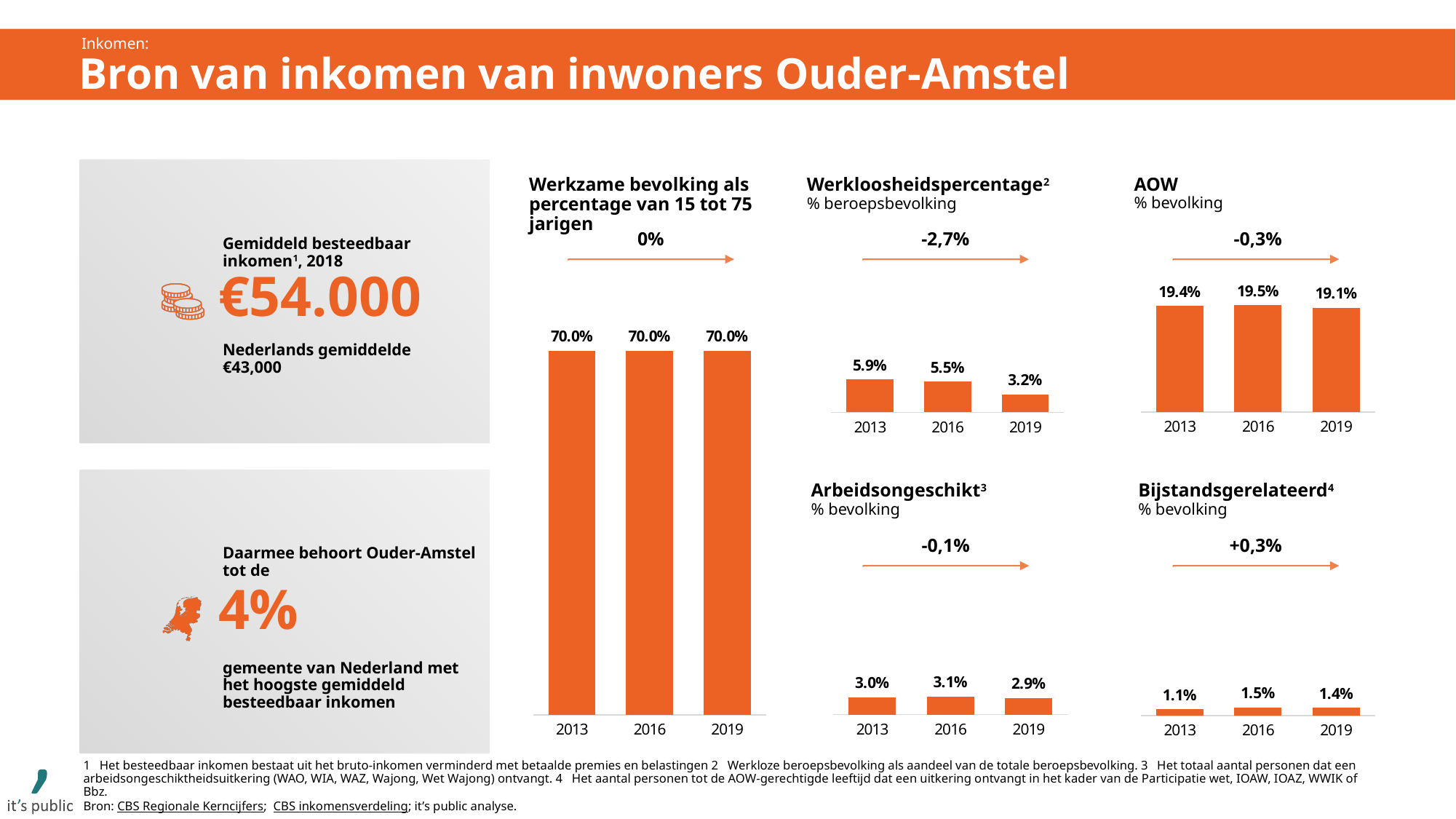
In the Arbeidsongeschikt chart, which year has the highest value? 2016 In the Werkloosheidspercentage chart, do the values rise or fall from 2013 to 2019? fall What is the value shown for every year in the Werkzame bevolking als percentage van 15 tot 75 jarigen chart? 70.0% In the Bijstandsgerelateerd chart, what is the value for 2013? 1.1% In the Werkloosheidspercentage chart, what is the difference between the 2013 and 2019 values? 2.7% How many bars are in the Werkzame bevolking als percentage van 15 tot 75 jarigen chart? 3 In the Werkloosheidspercentage chart, which year has the lowest value? 2019 In the AOW chart, which is larger, the value for 2013 or the value for 2019? 2013 In the Werkloosheidspercentage chart, what is the value for 2019? 3.2% In the Bijstandsgerelateerd chart, what is the difference between the 2016 and 2013 values? 0.4% In the AOW chart, what is the value for 2016? 19.5% What type of chart is the AOW chart? bar chart